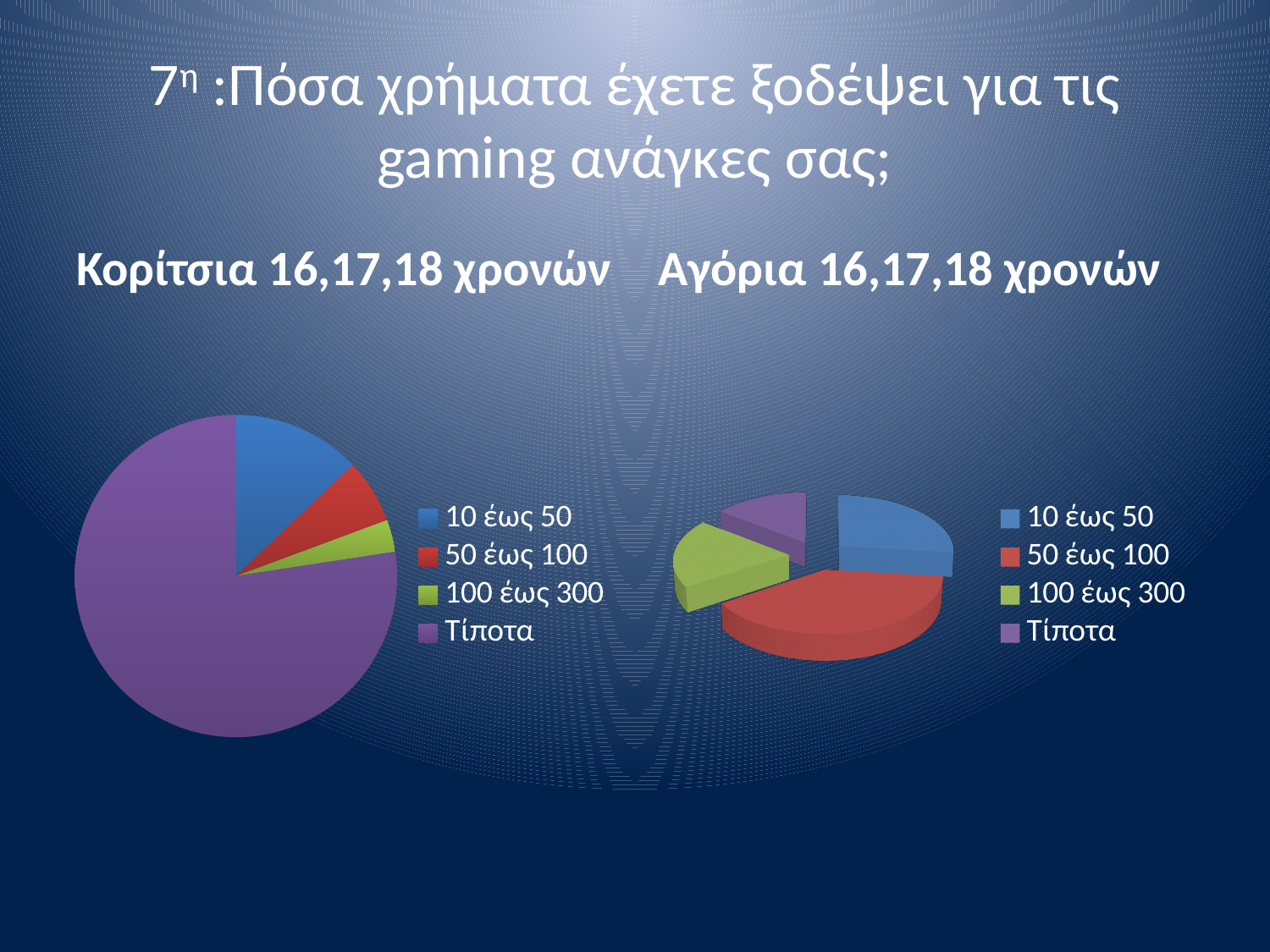
In the right chart 'Αγόρια 16,17,18 χρονών', which slice is larger: '50 έως 100' or '10 έως 50'? 50 έως 100 In the left chart 'Κορίτσια 16,17,18 χρονών', which category has the largest slice? Τίποτα In the left chart 'Κορίτσια 16,17,18 χρονών', how many categories does the legend list? 4 In the right chart 'Αγόρια 16,17,18 χρονών', how many slices does the pie have? 4 In the left chart 'Κορίτσια 16,17,18 χρονών', which category has the smallest slice? 100 έως 300 In the left chart 'Κορίτσια 16,17,18 χρονών', which slice is larger: 'Τίποτα' or '10 έως 50'? Τίποτα In the right chart 'Αγόρια 16,17,18 χρονών', which slice is larger: '10 έως 50' or 'Τίποτα'? 10 έως 50 What is the title of the chart on the left of the slide? Κορίτσια 16,17,18 χρονών In the right chart 'Αγόρια 16,17,18 χρονών', which category has the largest slice? 50 έως 100 What kind of chart is the left chart titled 'Κορίτσια 16,17,18 χρονών'? pie chart In the right chart 'Αγόρια 16,17,18 χρονών', what colour is the 'Τίποτα' slice? purple What kind of chart is the right chart titled 'Αγόρια 16,17,18 χρονών'? pie chart